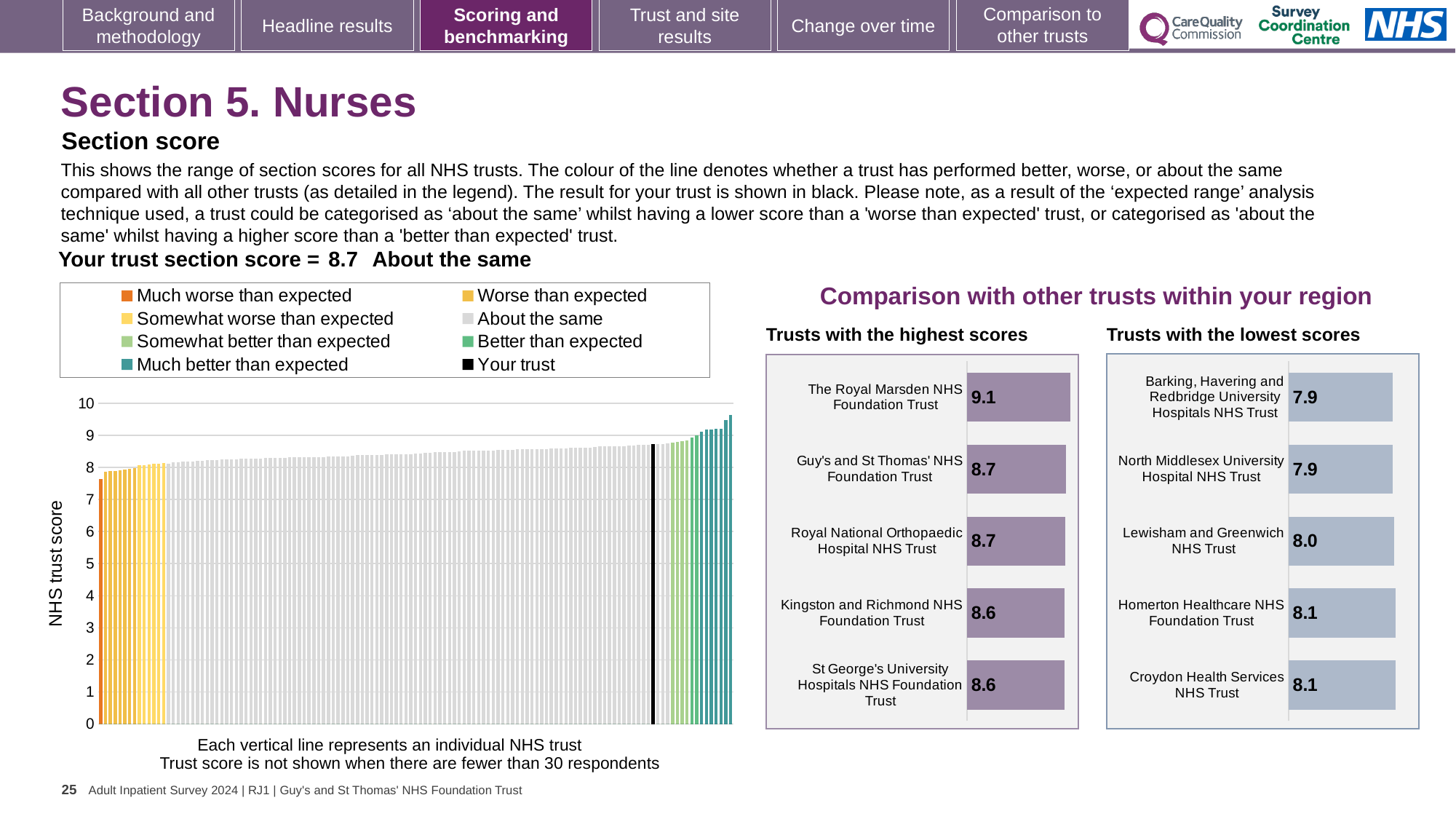
In the large chart on the left, do the trust scores rise or fall from left to right? Rise In the large chart on the left, is the value for the black 'Your trust' bar greater or less than 8? greater In the 'Trusts with the highest scores' chart, what is the difference between the scores of The Royal Marsden NHS Foundation Trust and Kingston and Richmond NHS Foundation Trust? 0.5 In the 'Trusts with the lowest scores' chart, what is the difference between the scores of Homerton Healthcare NHS Foundation Trust and Barking, Havering and Redbridge University Hospitals NHS Trust? 0.2 In the 'Trusts with the lowest scores' chart, what is the score for Lewisham and Greenwich NHS Trust? 8.0 How many entries does the legend of the large chart on the left list? 8 In the 'Trusts with the lowest scores' chart, which has the larger score: Lewisham and Greenwich NHS Trust or Homerton Healthcare NHS Foundation Trust? Homerton Healthcare NHS Foundation Trust In the 'Trusts with the highest scores' chart, which trust has the highest score? The Royal Marsden NHS Foundation Trust In the 'Trusts with the highest scores' chart, what is the score for The Royal Marsden NHS Foundation Trust? 9.1 How many trusts are shown in the 'Trusts with the highest scores' chart? 5 In the 'Trusts with the lowest scores' chart, what is the score for North Middlesex University Hospital NHS Trust? 7.9 What kind of chart is the large chart on the left showing NHS trust scores? Bar chart